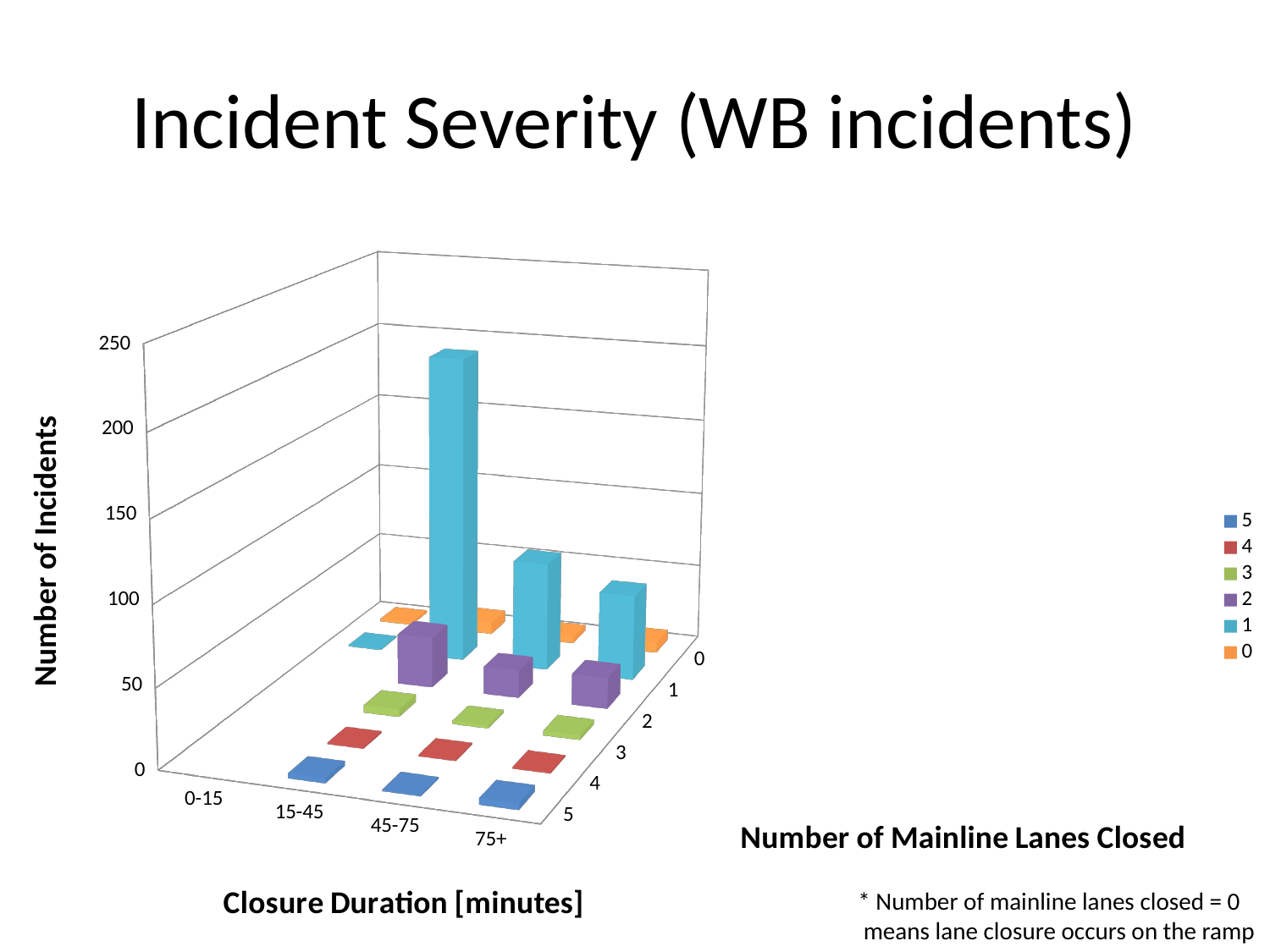
Which series (number of mainline lanes closed) has the tallest bar in the chart? 1 For the series '1' (one mainline lane closed), which closure duration has the highest number of incidents? 15-45 What is the title of the horizontal axis showing the categories 0-15, 15-45, 45-75 and 75+? Closure Duration [minutes] How many closure duration categories are shown on the x axis? 4 For series '1', is the number of incidents larger for closure duration 15-45 or 45-75? 15-45 What is the title of the vertical axis? Number of Incidents How many series does the legend list? 6 What kind of chart is shown on the slide? bar chart For the series '1', which closure duration has the lowest number of incidents? 0-15 For closure duration 15-45, is the number of incidents larger for series '2' or series '3'? 2 Is the number of incidents for series '1' at closure duration 0-15 greater or less than 50? less Is the number of incidents for series '1' at closure duration 15-45 greater or less than 100? greater